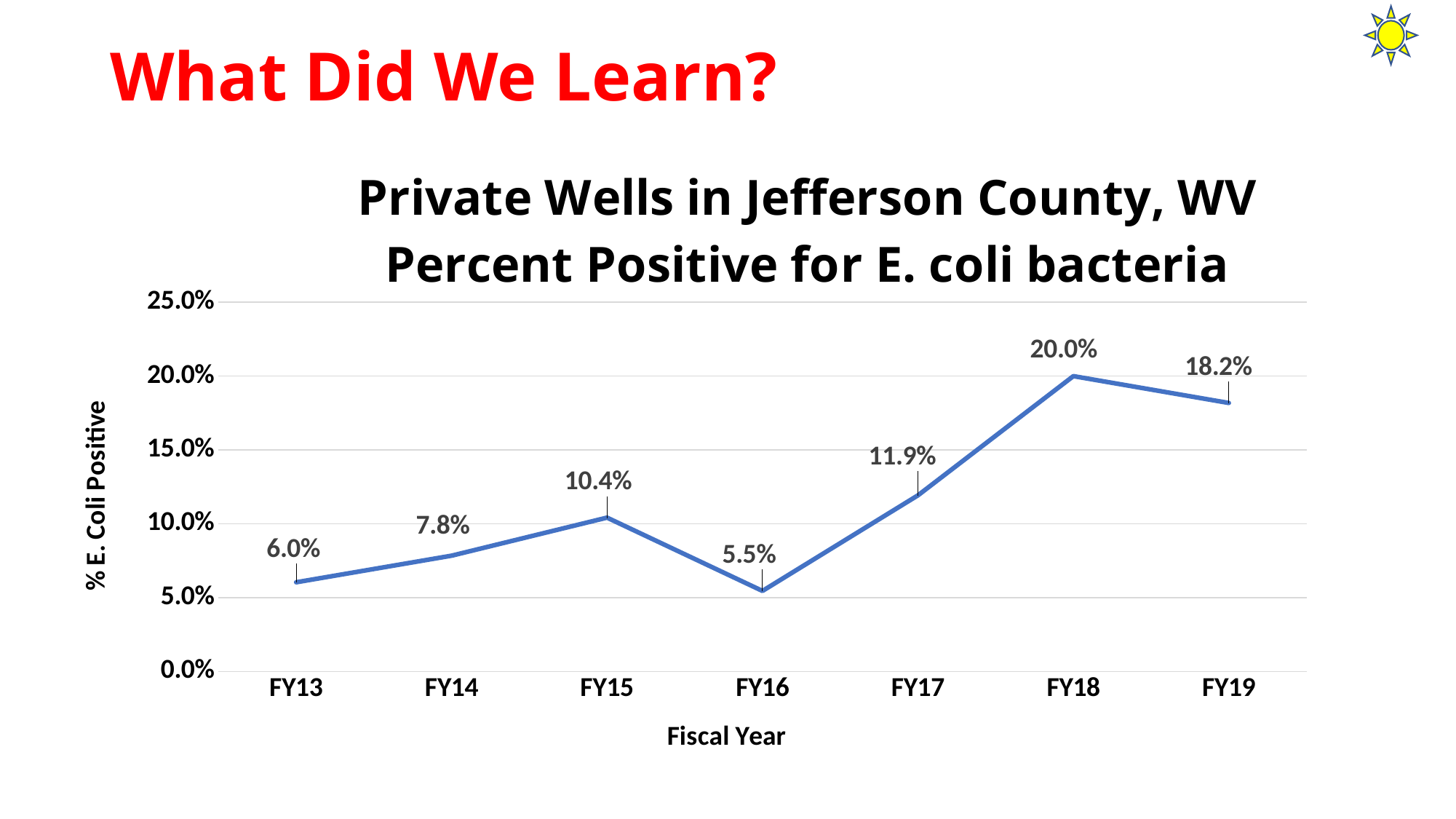
What is the difference between the percent positive in FY18 and FY16? 14.5% What is the percent positive for E. coli in FY19? 18.2% Which fiscal year has the lowest percent positive for E. coli? FY16 What kind of chart is shown on the slide? Line chart What is the percent positive for E. coli in FY17? 11.9% Which fiscal year has the highest percent positive for E. coli? FY18 What is the label of the y axis? % E. Coli Positive What is the difference between the percent positive in FY15 and FY14? 2.6% Is the value for FY19 greater or less than 15.0%? greater What is the percent positive for E. coli in FY13? 6.0% Which fiscal year has a higher percent positive, FY15 or FY17? FY17 How many fiscal years are plotted on the chart? 7